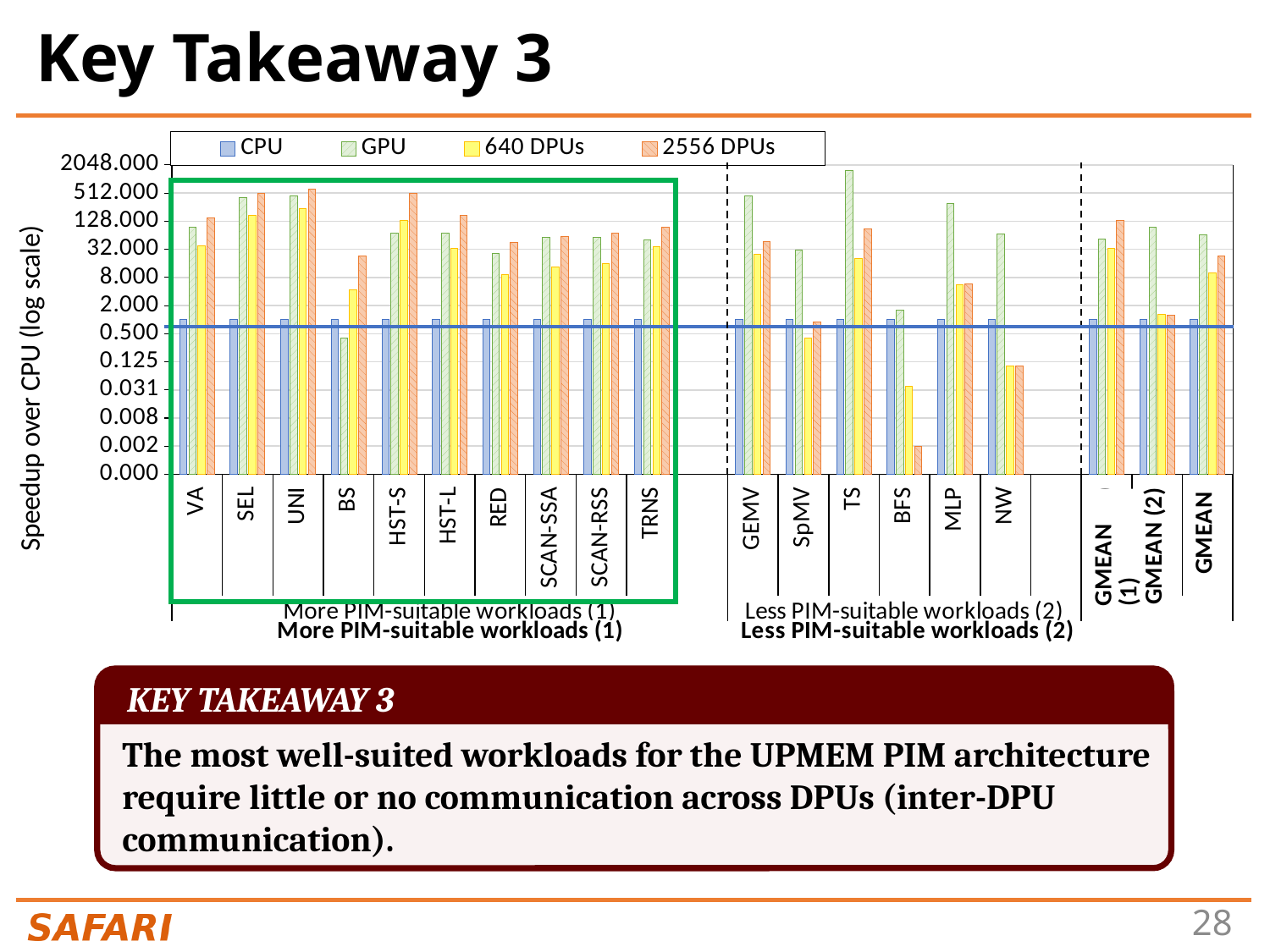
How many workloads are in the 'More PIM-suitable workloads (1)' group? 10 Which series are listed in the legend? CPU, GPU, 640 DPUs, 2556 DPUs For BFS, which is larger: the GPU value or the 640 DPUs value? GPU Is the 2556 DPUs value for BFS greater or less than 0.008? less Is the GPU value for GEMV greater or less than 128? greater What kind of chart is shown on the slide? bar chart What is the label of the y axis? Speedup over CPU (log scale) How many workloads are in the 'Less PIM-suitable workloads (2)' group? 6 How many series does the legend list? 4 Which workload has the highest GPU speedup? TS Is the GPU value for TS greater or less than 512? greater